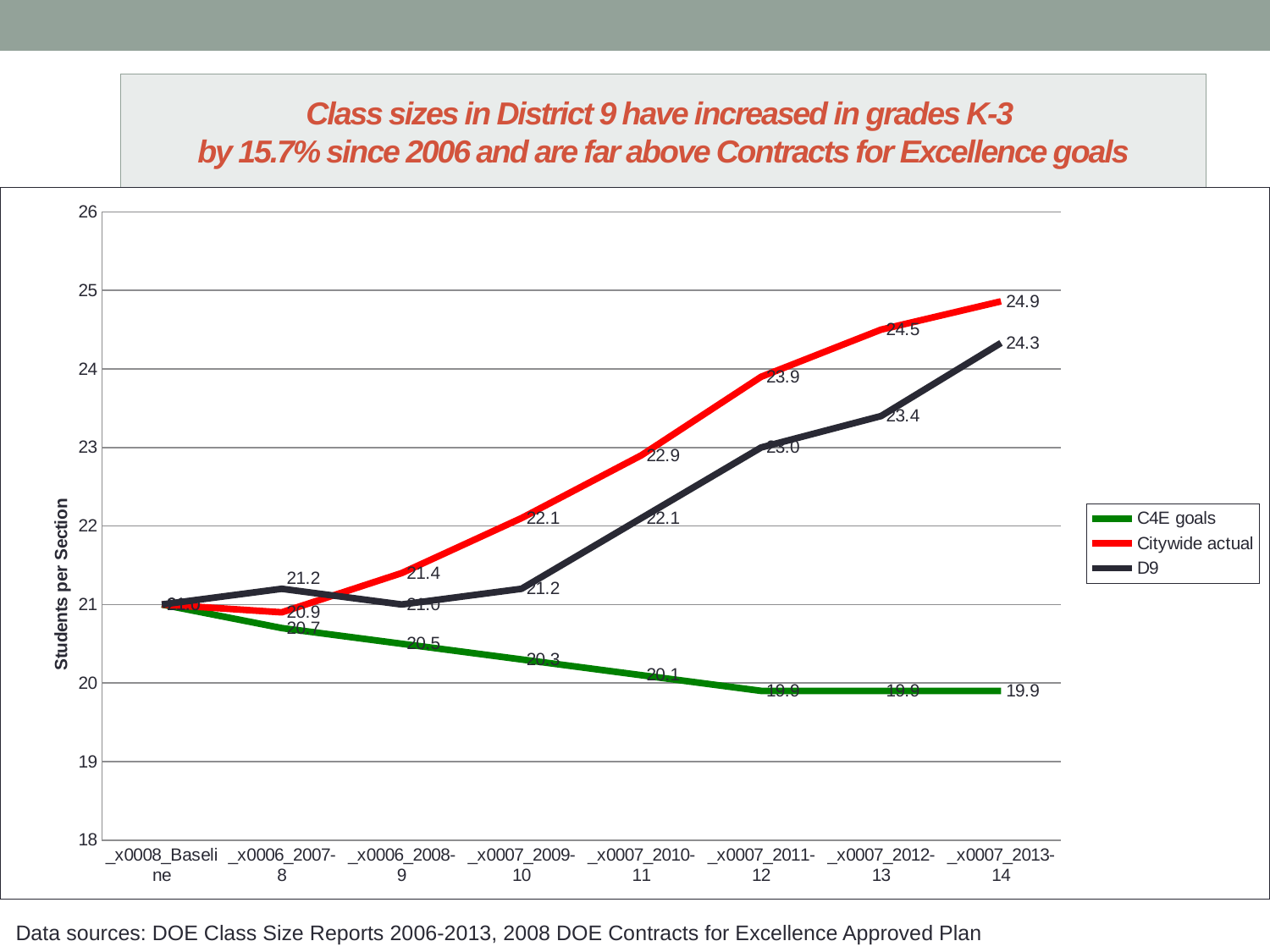
What is the title of the y axis? Students per Section Do the Citywide actual values rise or fall from 2008-9 to 2013-14? rise What is the C4E goals value for 2013-14? 19.9 How many categories are shown on the x axis? 8 What kind of chart is shown on the slide? line chart Do the C4E goals values rise or fall from the Baseline to 2013-14? fall What is the Citywide actual value for 2013-14? 24.9 Which series has the highest value in 2013-14? Citywide actual How many series does the legend list? 3 Which is larger in 2012-13, the D9 value or the Citywide actual value? Citywide actual What is the D9 value for 2013-14? 24.3 What is the difference between the Citywide actual and D9 values in 2013-14? 0.6